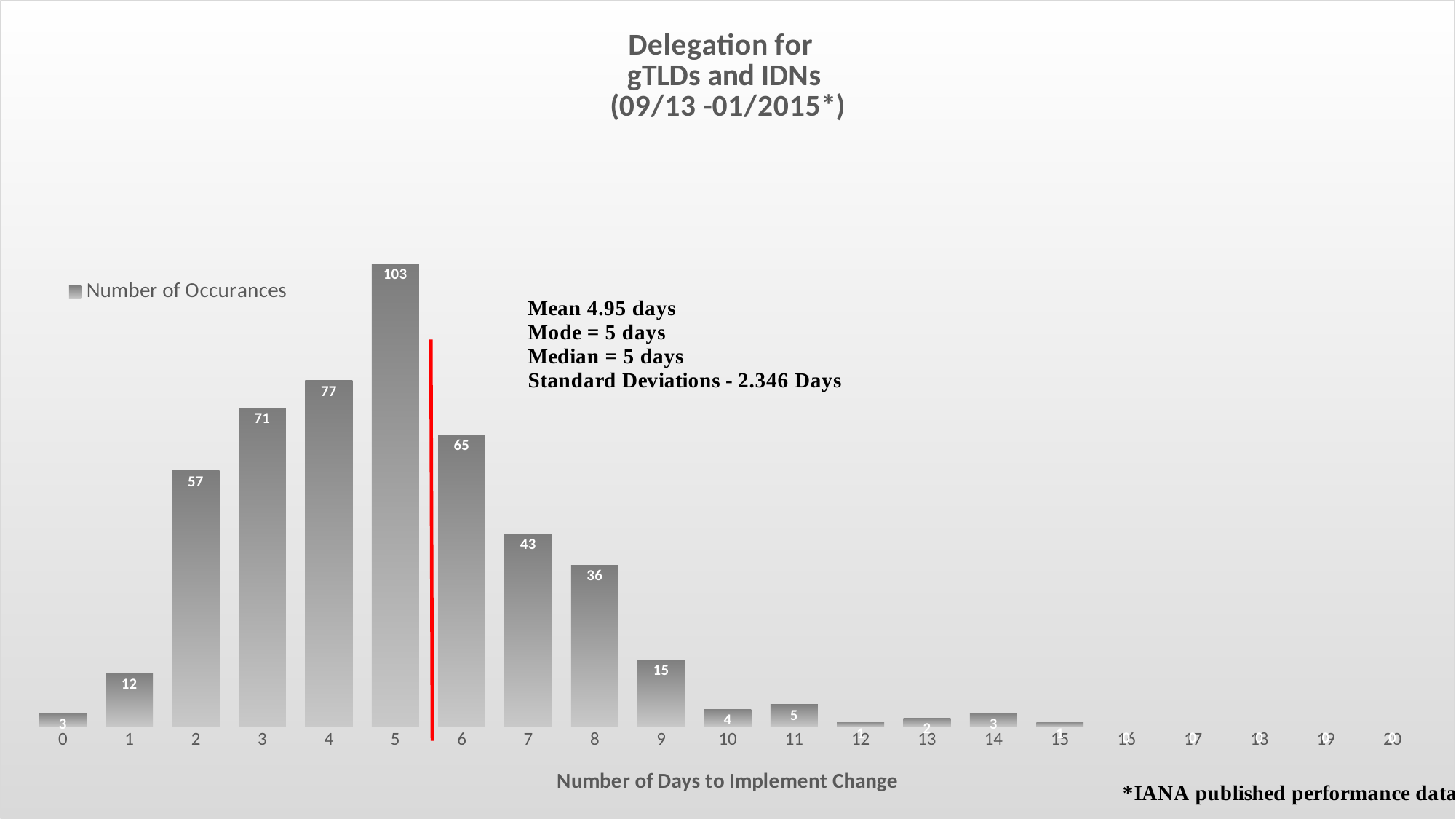
What kind of chart is shown on the slide? Bar chart Which has more occurrences, 3 days or 4 days? 4 days What is the number of occurrences for 9 days to implement change? 15 Which number of days has the highest number of occurrences? 5 What is the difference between the number of occurrences for 7 days and for 8 days? 7 What is the number of occurrences for 2 days to implement change? 57 What is the title of the x axis? Number of Days to Implement Change Do the number of occurrences rise or fall from 5 days to 9 days? Fall What is the number of occurrences for 5 days to implement change? 103 How many series does the legend list? 1 What is the difference between the number of occurrences for 5 days and for 6 days? 38 How many categories (number of days) are shown on the x axis? 21